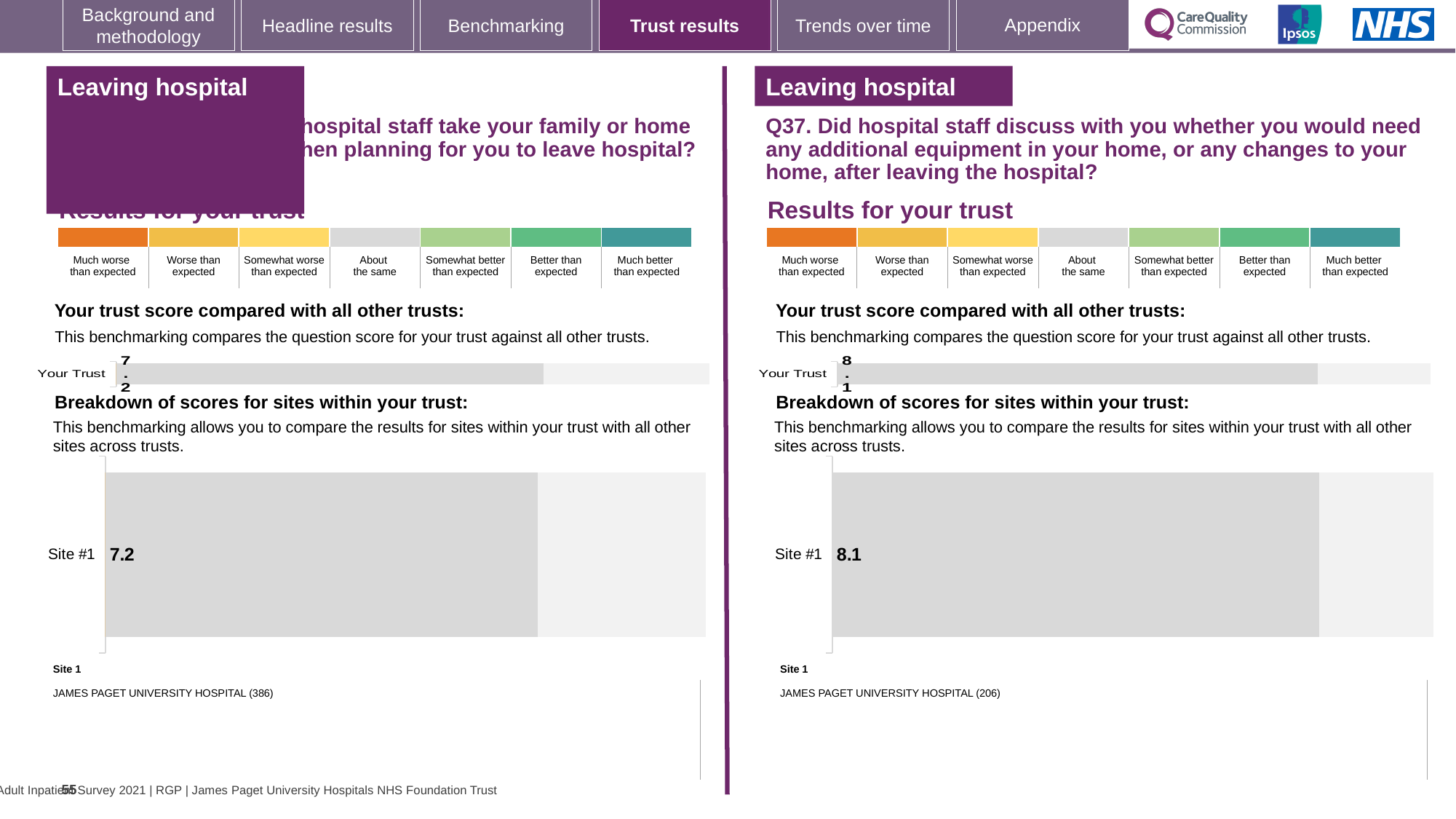
What is the difference between the 'Your Trust' score on the right half (Q37) and the 'Your Trust' score on the left half of the slide? 0.9 On the left half of the slide, what score is shown for Site #1 in the breakdown of scores chart? 7.2 On the left half of the slide, what is the score shown for 'Your Trust' in the trust score bar chart? 7.2 On the right half of the slide (Q37), what score is shown for Site #1 in the breakdown of scores chart? 8.1 What type of chart is used to show the Site #1 score in the breakdown of scores section? Bar chart On the right half of the slide (Q37), what is the score shown for 'Your Trust' in the trust score bar chart? 8.1 Which 'Your Trust' score is larger: the one on the left half of the slide or the one on the right half (Q37)? The right half (Q37), 8.1 Which hospital is listed as Site 1 below the breakdown charts? JAMES PAGET UNIVERSITY HOSPITAL On the left half of the slide, is the Site #1 score equal to the 'Your Trust' score? Yes, both are 7.2 What number appears in parentheses after the Site 1 hospital name on the right half of the slide (Q37)? 206 What is the difference between the Site #1 score on the right half (Q37) and the Site #1 score on the left half of the slide? 0.9 How many sites are shown in the breakdown of scores chart on the right half of the slide (Q37)? 1